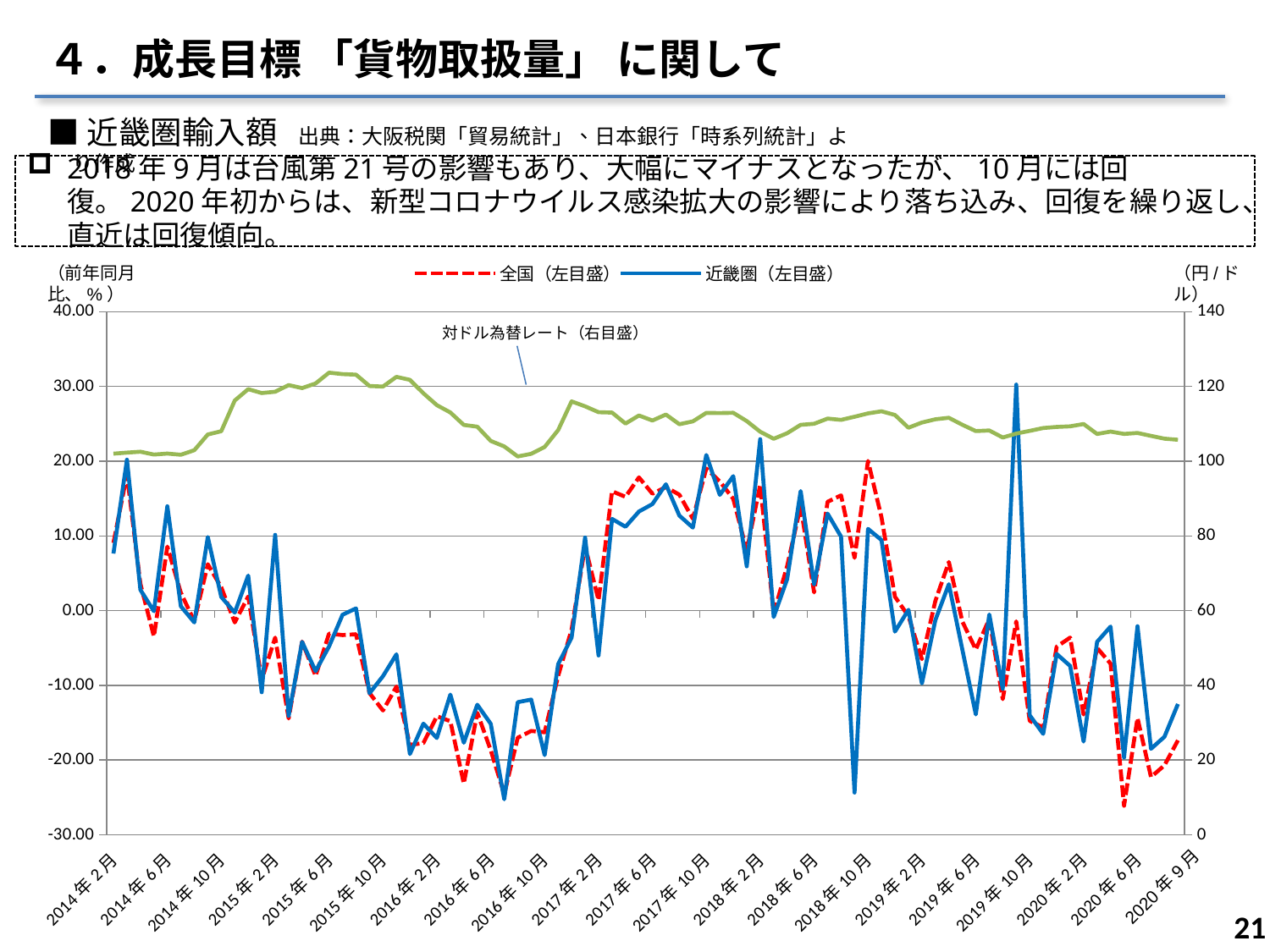
Which series is plotted against the right axis (右目盛)? 対ドル為替レート Is the value for 近畿圏 in 2018年10月 greater or less than -20.00? greater In 2018年10月, which series has the larger value, 全国 or 近畿圏? 全国 Is the value for 近畿圏 in 2016年6月 greater or less than -20.00? greater Is the value for 全国 in 2017年6月 greater or less than 10.00? greater How many series does the legend at the top of the chart list? 2 What are the two series named in the chart legend? 全国（左目盛）and 近畿圏（左目盛） What kind of chart is shown on the slide? line chart